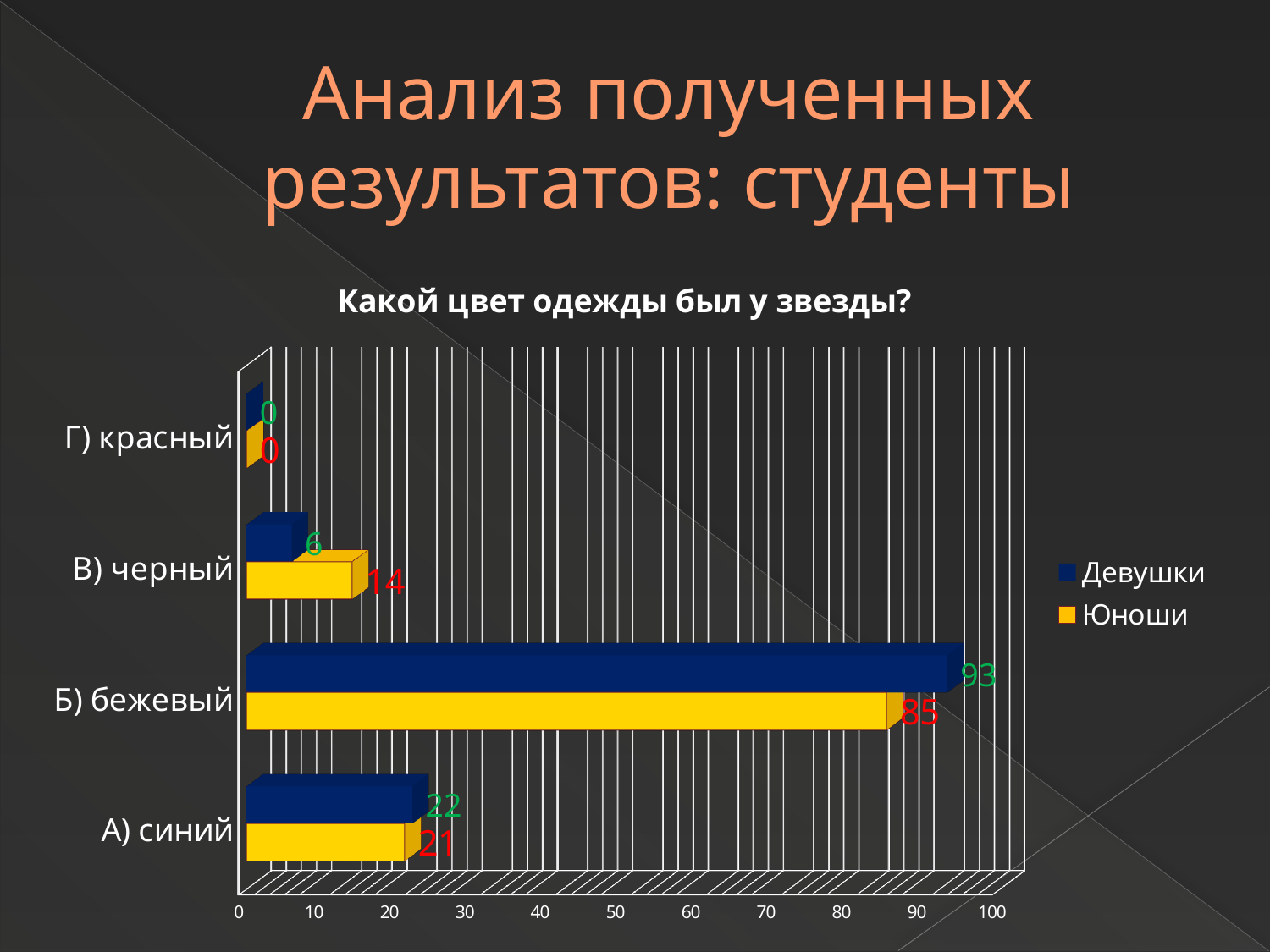
How many series does the legend list? 2 What is the value for Юноши in the category В) черный? 14 What type of chart is shown on the slide? bar chart What is the value for Девушки in the category Б) бежевый? 93 What is the title of the chart? Какой цвет одежды был у звезды? How many categories are shown on the chart? 4 Which series is shown in yellow? Юноши Which category has the lowest value for Юноши? Г) красный What is the value for Юноши in the category А) синий? 21 Which category has the highest value for Девушки? Б) бежевый In the category В) черный, which series has the larger value, Девушки or Юноши? Юноши What is the difference between the Девушки and Юноши values for Б) бежевый? 8